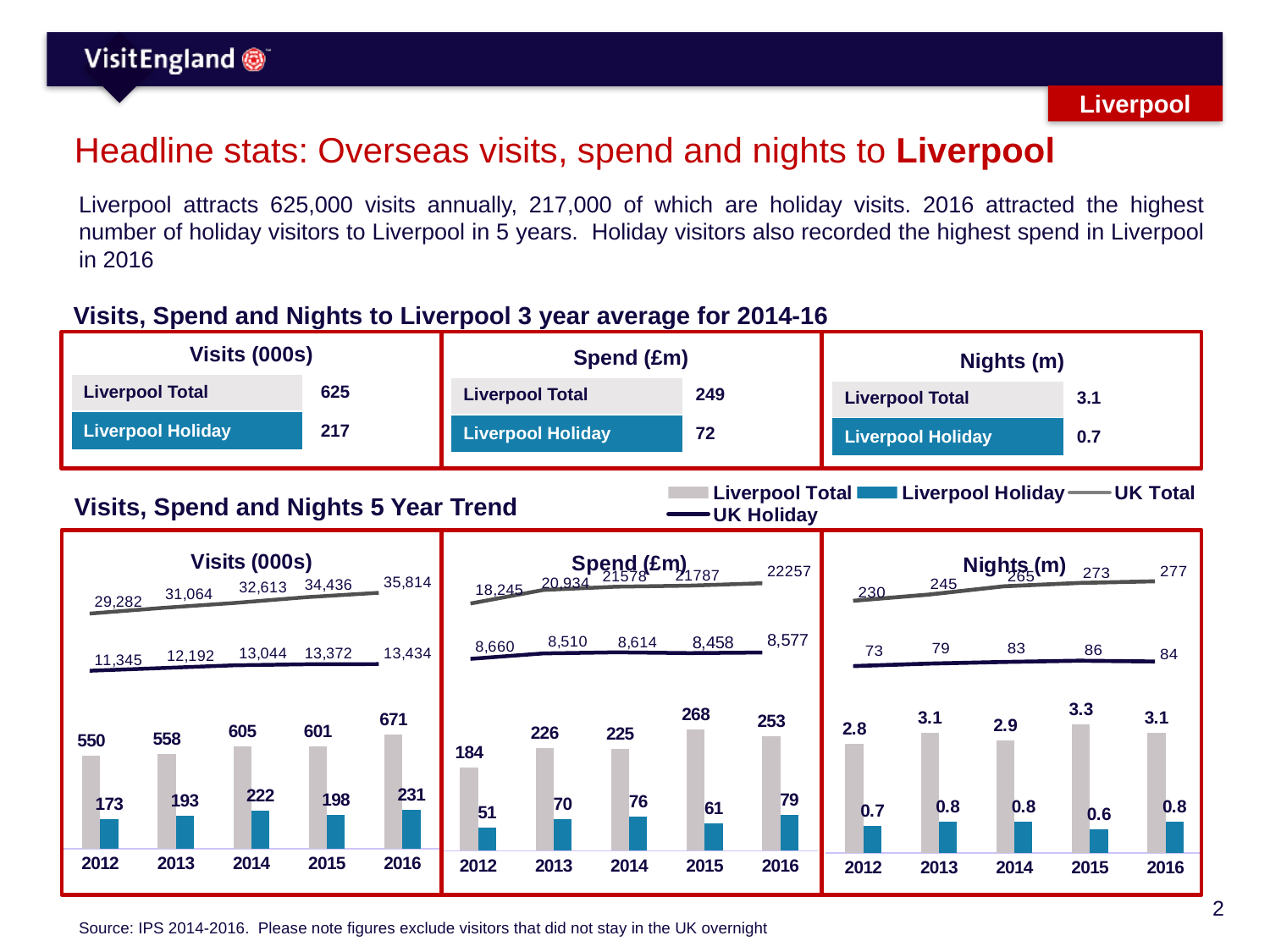
What kind of chart is the Spend (£m) 5 Year Trend chart? bar and line chart In the Spend (£m) trend chart, what is the UK Total value for 2016? 22257 In the Nights (m) trend chart, which year has the lowest Liverpool Holiday value? 2015 In the Visits (000s) trend chart, what is the Liverpool Total value for 2016? 671 In the Spend (£m) trend chart, what is the difference between the Liverpool Total values for 2015 and 2012? 84 In the Visits (000s) trend chart, which year has the highest Liverpool Holiday value? 2016 How many years are shown on the x axis of the Visits (000s) trend chart? 5 In the Spend (£m) trend chart, which year has the larger Liverpool Holiday value, 2014 or 2015? 2014 In the Nights (m) trend chart, what is the UK Holiday value for 2014? 83 How many series does the legend for the 5 Year Trend charts list? 4 In the Visits (000s) trend chart, does the UK Total line rise or fall from 2012 to 2016? rises In the Nights (m) trend chart, what is the Liverpool Holiday value for 2015? 0.6